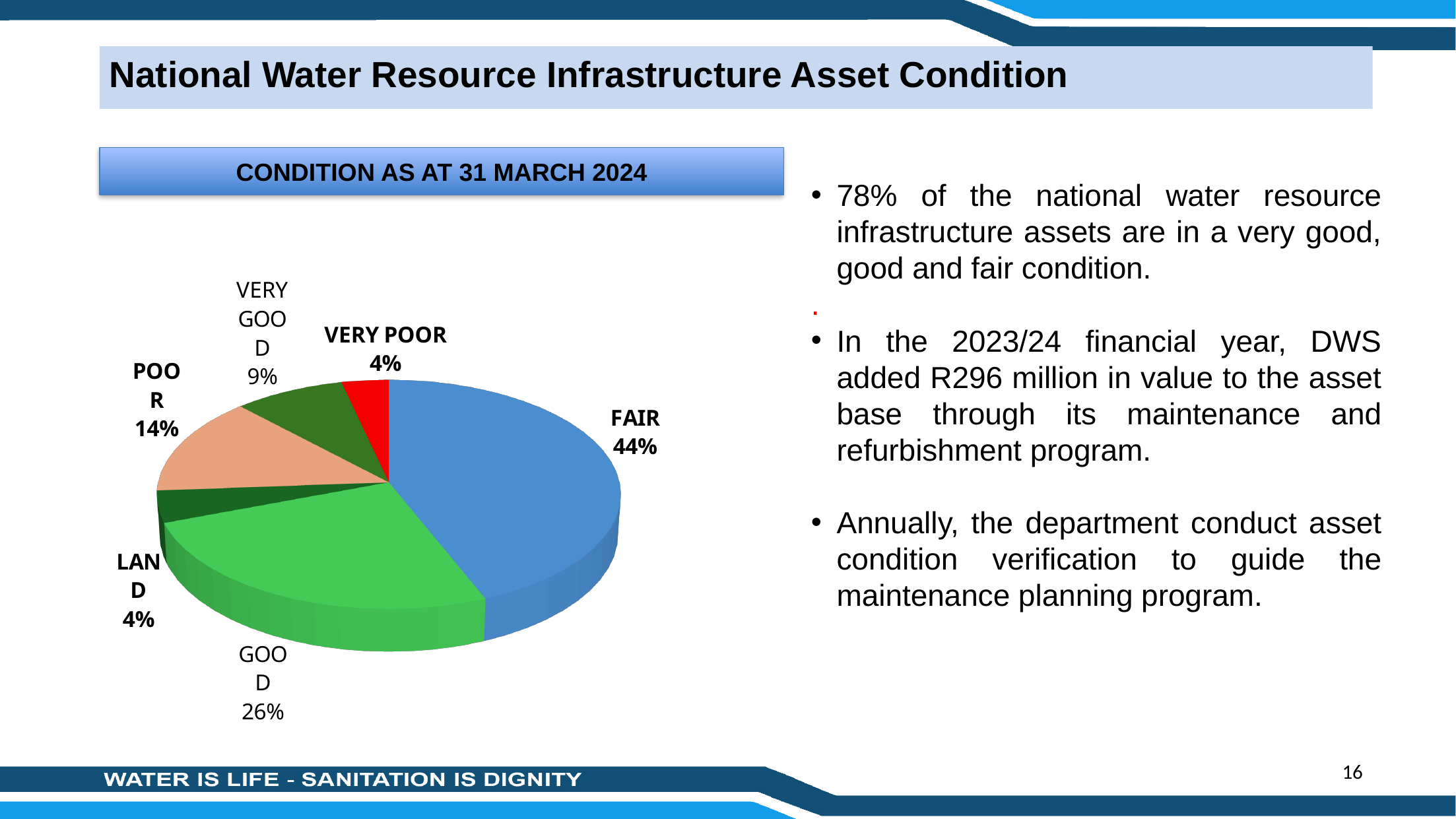
What is the difference in percentage points between the FAIR and GOOD slices? 18 What share of assets is in VERY GOOD condition? 9% Which condition category has the largest slice of the pie? FAIR What is the title shown above the pie chart? CONDITION AS AT 31 MARCH 2024 What share of assets is in GOOD condition? 26% What share is shown for the LAND slice? 4% What share of assets is in POOR condition? 14% What share of assets is in FAIR condition? 44% Which slice is larger, POOR or VERY GOOD? POOR What share of assets is in VERY POOR condition? 4% How many slices does the pie chart have? 6 What kind of chart is shown on the slide? pie chart